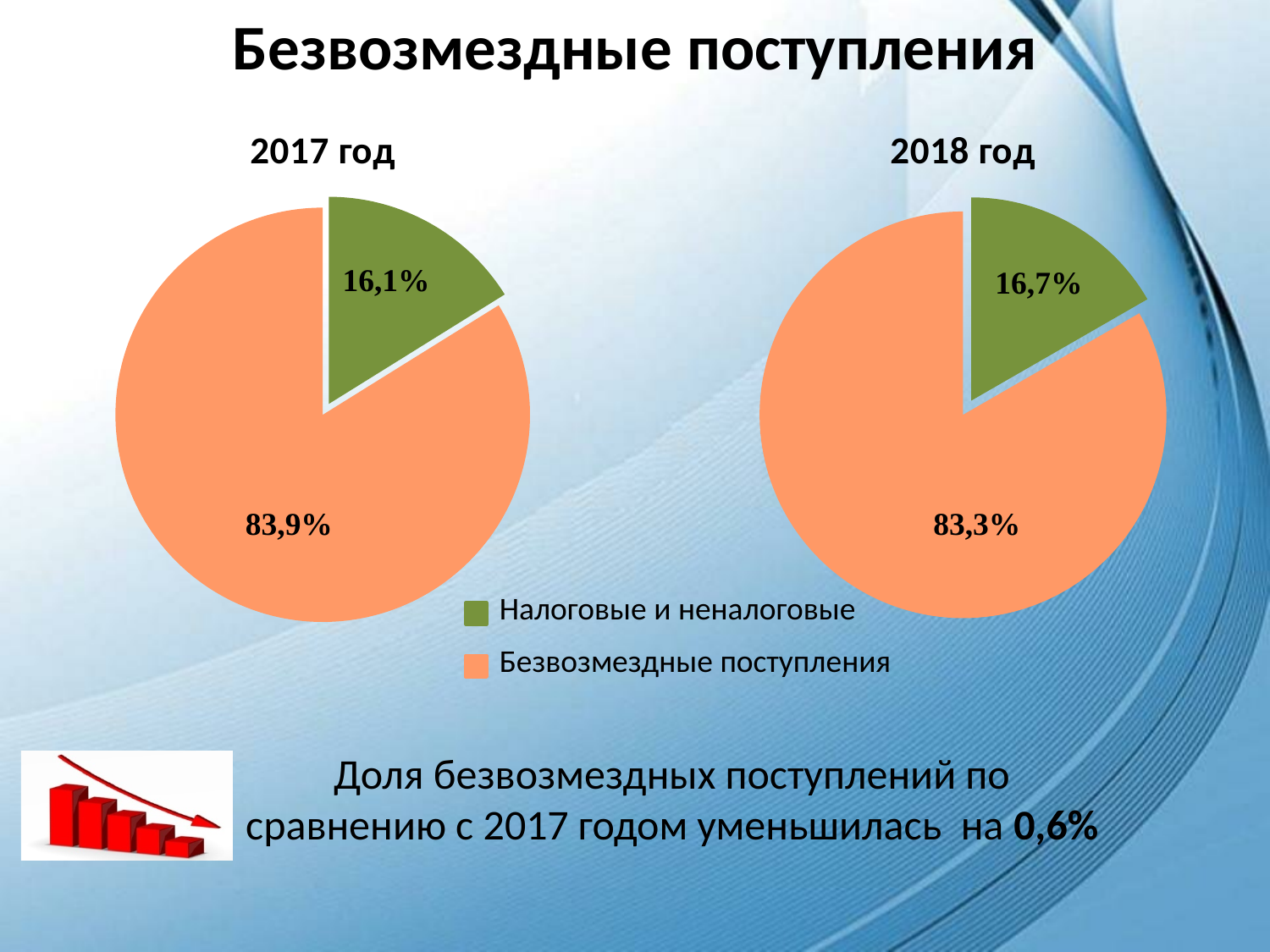
In the 2017 год pie chart, which category has the smallest slice? Налоговые и неналоговые What type of chart is used for the 2017 год data? Pie chart Which is larger: the Налоговые и неналоговые share in the 2017 год chart or in the 2018 год chart? 2018 год In the 2017 год pie chart, what share is shown for Налоговые и неналоговые? 16,1% What colour represents Безвозмездные поступления in the pie charts? Orange In the 2018 год pie chart, what share is shown for Безвозмездные поступления? 83,3% In the 2018 год pie chart, which category has the largest slice? Безвозмездные поступления How many entries does the shared legend list? 2 In the 2017 год pie chart, what share is shown for Безвозмездные поступления? 83,9% What is the difference between the Безвозмездные поступления share in the 2017 год chart and in the 2018 год chart? 0,6% How many slices does the 2018 год pie chart have? 2 In the 2018 год pie chart, what share is shown for Налоговые и неналоговые? 16,7%